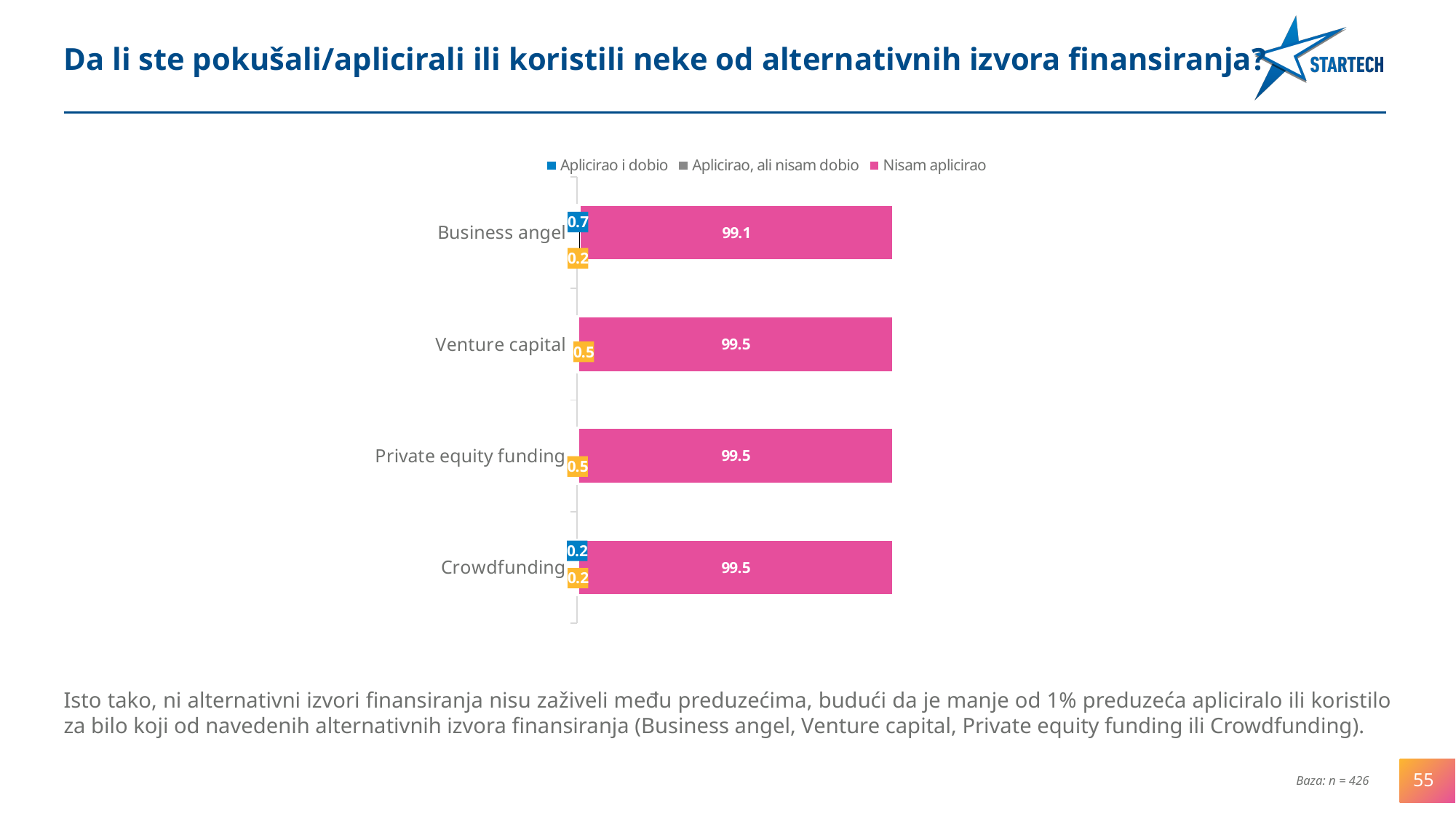
How many series does the legend list? 3 What is the value of "Nisam aplicirao" for Business angel? 99.1 Which has a larger "Aplicirao i dobio" value, Business angel or Crowdfunding? Business angel What is the value of "Nisam aplicirao" for Venture capital? 99.5 Which has a larger "Nisam aplicirao" value, Business angel or Crowdfunding? Crowdfunding What is the value of "Aplicirao i dobio" for Business angel? 0.7 What is the value of "Aplicirao i dobio" for Crowdfunding? 0.2 Which category has the lowest value for "Nisam aplicirao"? Business angel How many categories are shown on the chart? 4 What kind of chart is shown on the slide? Bar chart What is the difference between the "Nisam aplicirao" values for Venture capital and Business angel? 0.4 What is the value of "Nisam aplicirao" for Private equity funding? 99.5